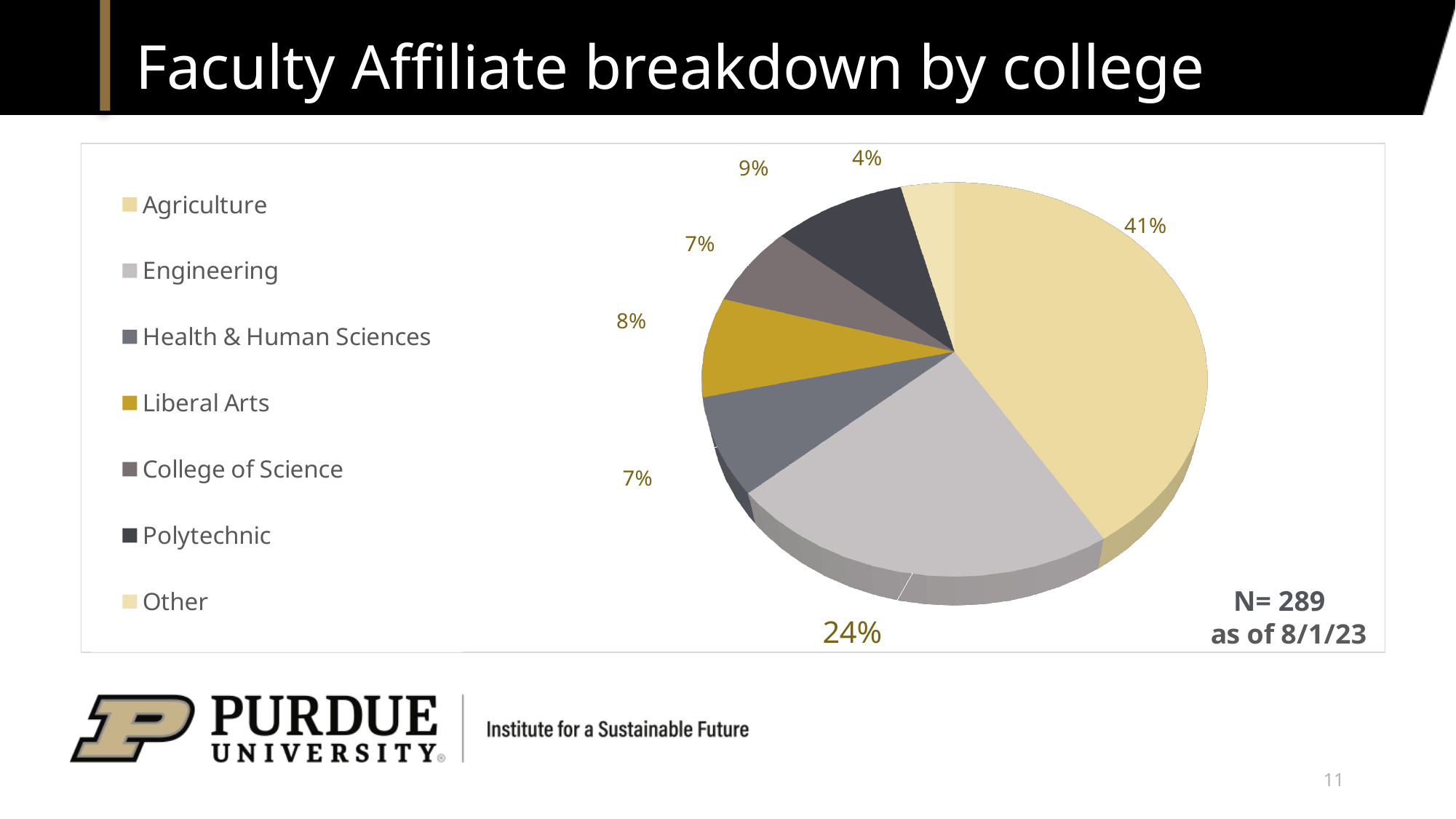
Which college has the largest share of faculty affiliates? Agriculture Which has a larger share, Polytechnic or Liberal Arts? Polytechnic How many categories does the pie chart show? 7 What type of chart is shown on the slide? pie chart What is the N value stated on the slide? N= 289 Which category has the smallest share of faculty affiliates? Other What share of faculty affiliates is from Agriculture? 41% What share of faculty affiliates is from Engineering? 24% What is the difference in percentage points between Agriculture and Engineering? 17 What share of faculty affiliates is from Health & Human Sciences? 7% What share of faculty affiliates is from Liberal Arts? 8% What share of faculty affiliates is from Polytechnic? 9%